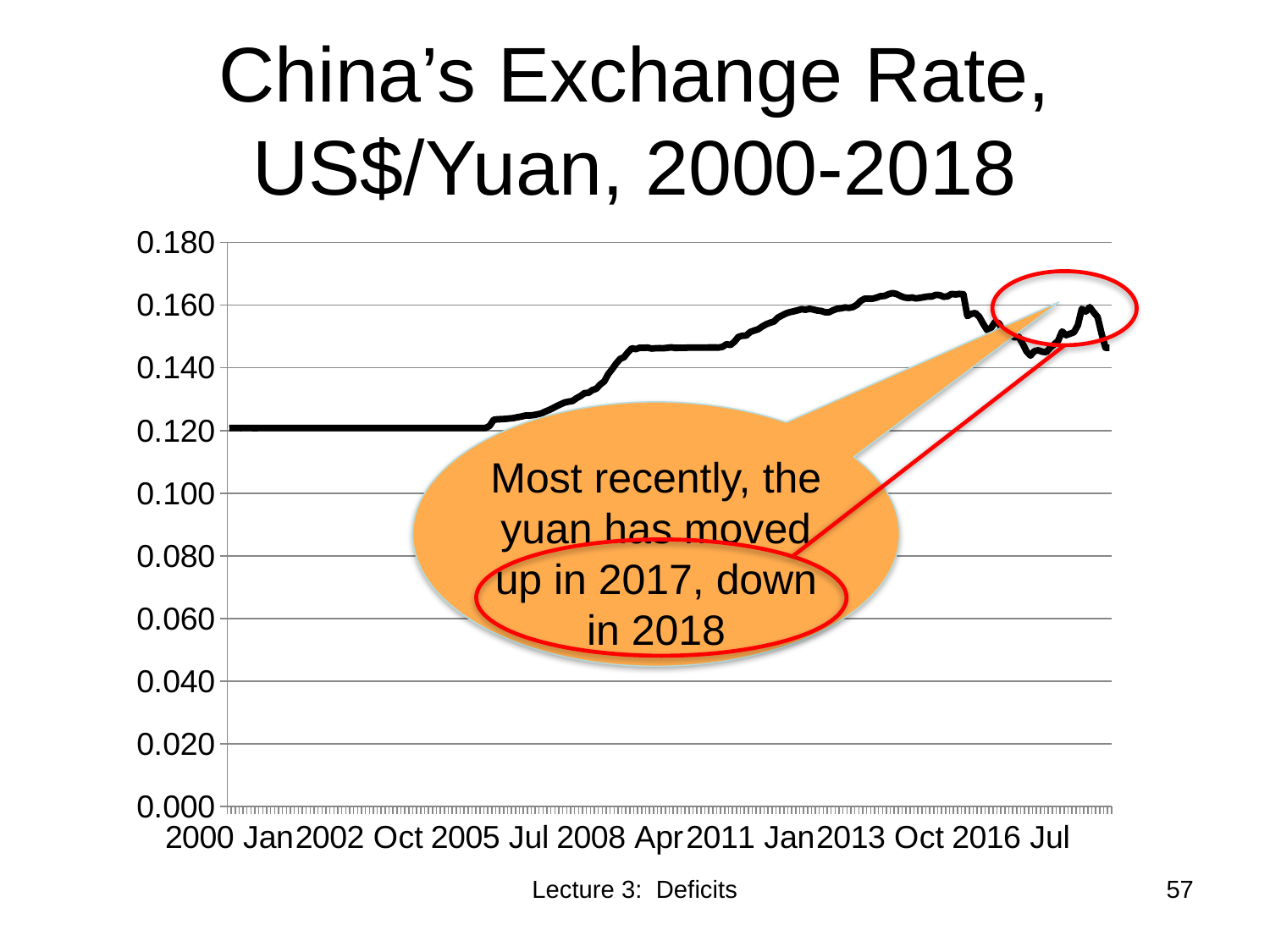
Is the exchange rate at 2000 Jan greater or less than 0.140? less What kind of chart is shown on the slide? Line chart Is the exchange rate at 2011 Jan greater or less than 0.120? greater How many year labels are shown along the x axis? 7 What is the highest value labelled on the y axis? 0.180 Does the exchange rate generally rise or fall from 2000 Jan to 2013 Oct? rise Is the exchange rate higher at 2005 Jul or at 2011 Jan? 2011 Jan Is the exchange rate higher at 2013 Oct or at 2000 Jan? 2013 Oct Is the exchange rate at 2000 Jan greater or less than 0.100? greater What is the title of the chart? China's Exchange Rate, US$/Yuan, 2000-2018